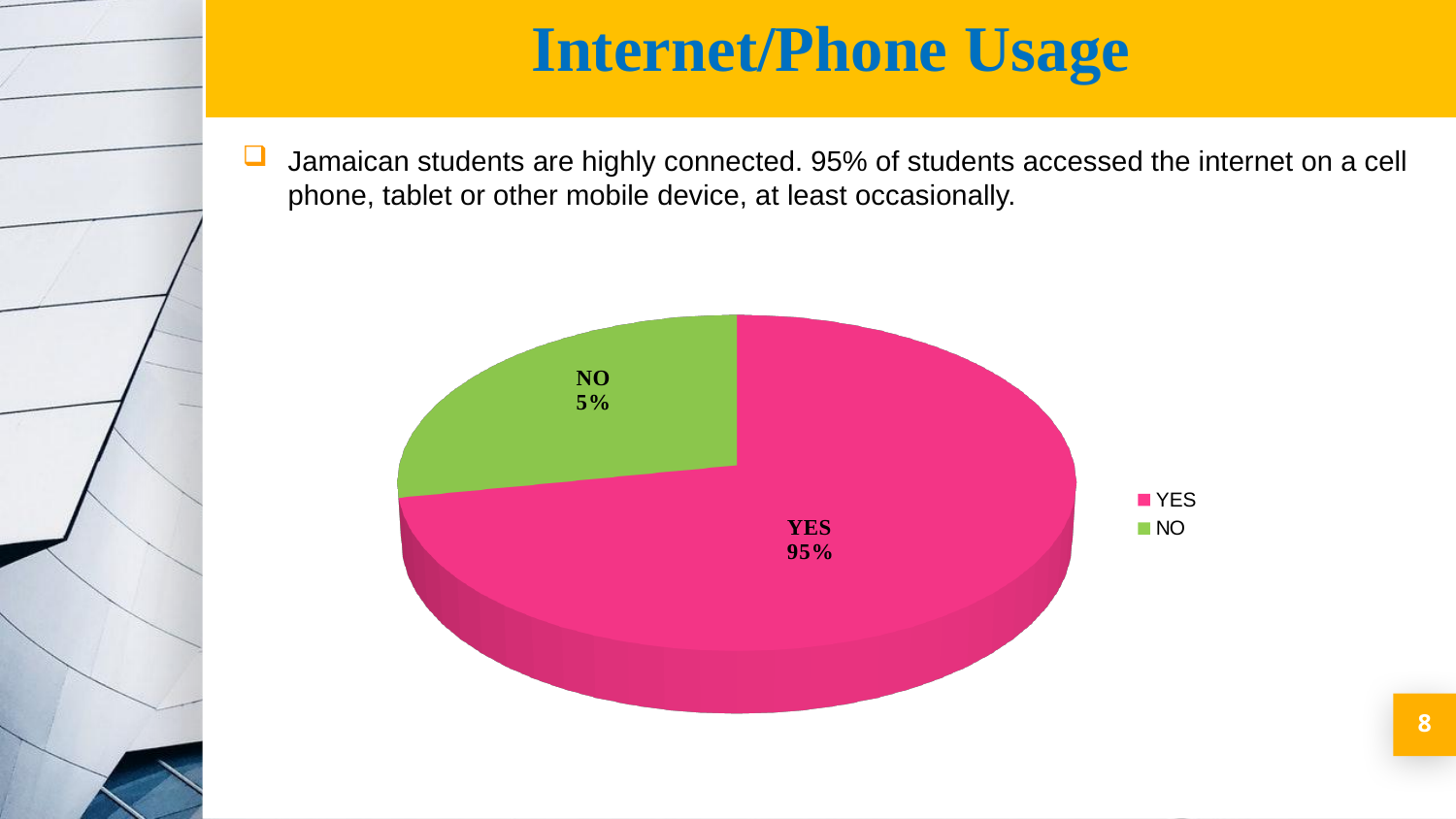
What colour is the YES slice in the pie chart? pink What is the difference in percentage points between the YES and NO slices? 90 Which slice of the pie is the smallest? NO What colour is the NO slice in the pie chart? green How many entries does the legend list? 2 What percentage of the pie is labelled YES? 95% Which slice of the pie is the largest? YES What share of the pie does the YES slice represent? 95% How many slices does the pie chart have? 2 Which is larger, the YES slice or the NO slice? YES What percentage of the pie is labelled NO? 5% What kind of chart is shown on the slide? pie chart